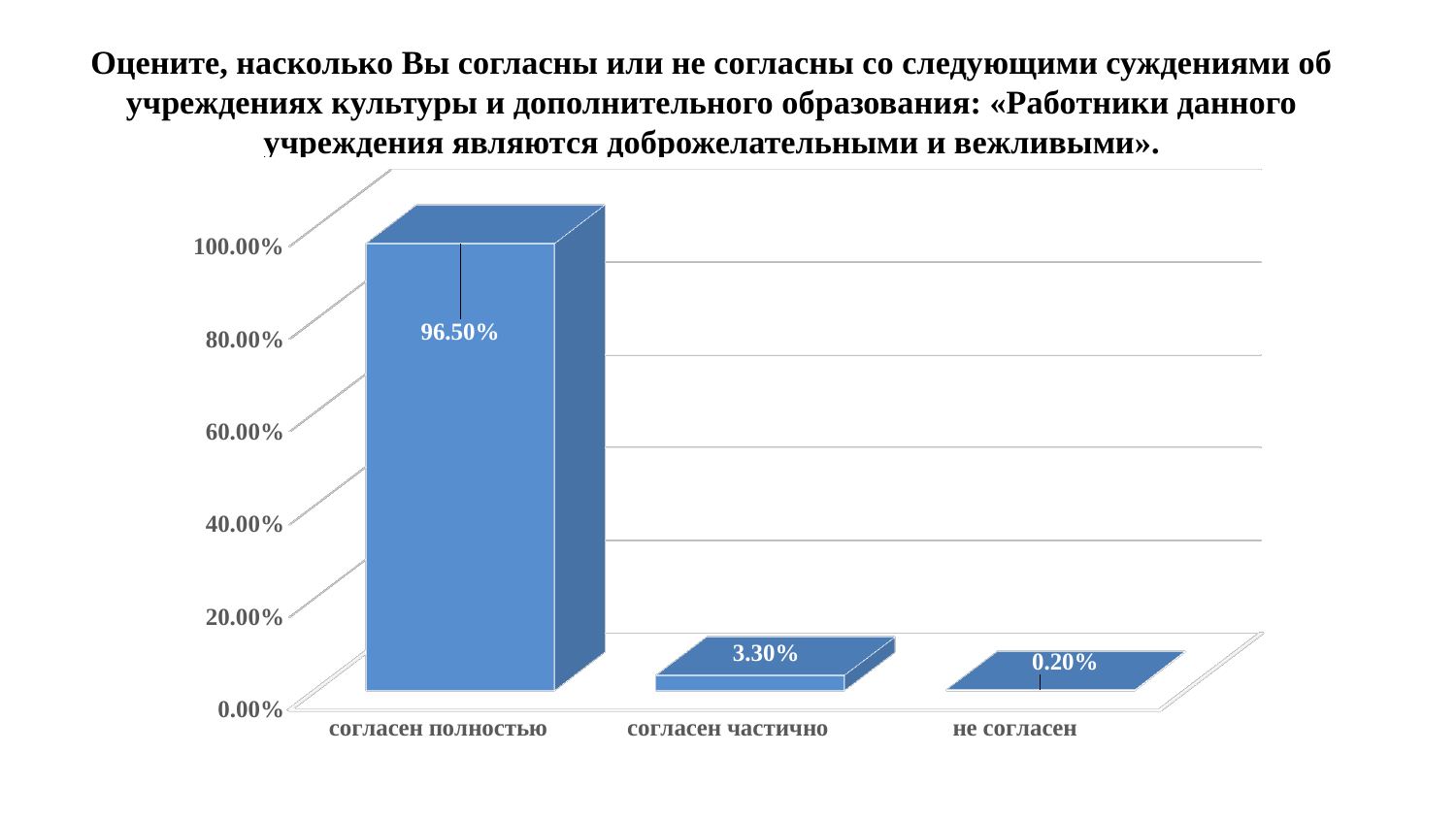
What is the difference between the values for "согласен полностью" and "согласен частично"? 93.20% What kind of chart is shown on the slide? bar chart Is the value for "согласен полностью" greater or less than 80.00%? greater Which is larger, the value for "согласен частично" or the value for "не согласен"? согласен частично Which category has the highest value? согласен полностью Which category has the lowest value? не согласен What is the value for "не согласен"? 0.20% What is the difference between the values for "согласен частично" and "не согласен"? 3.10% How many categories are shown on the x axis? 3 Do the values rise or fall from left to right along the x axis? fall What is the value for "согласен частично"? 3.30% What is the value for "согласен полностью"? 96.50%